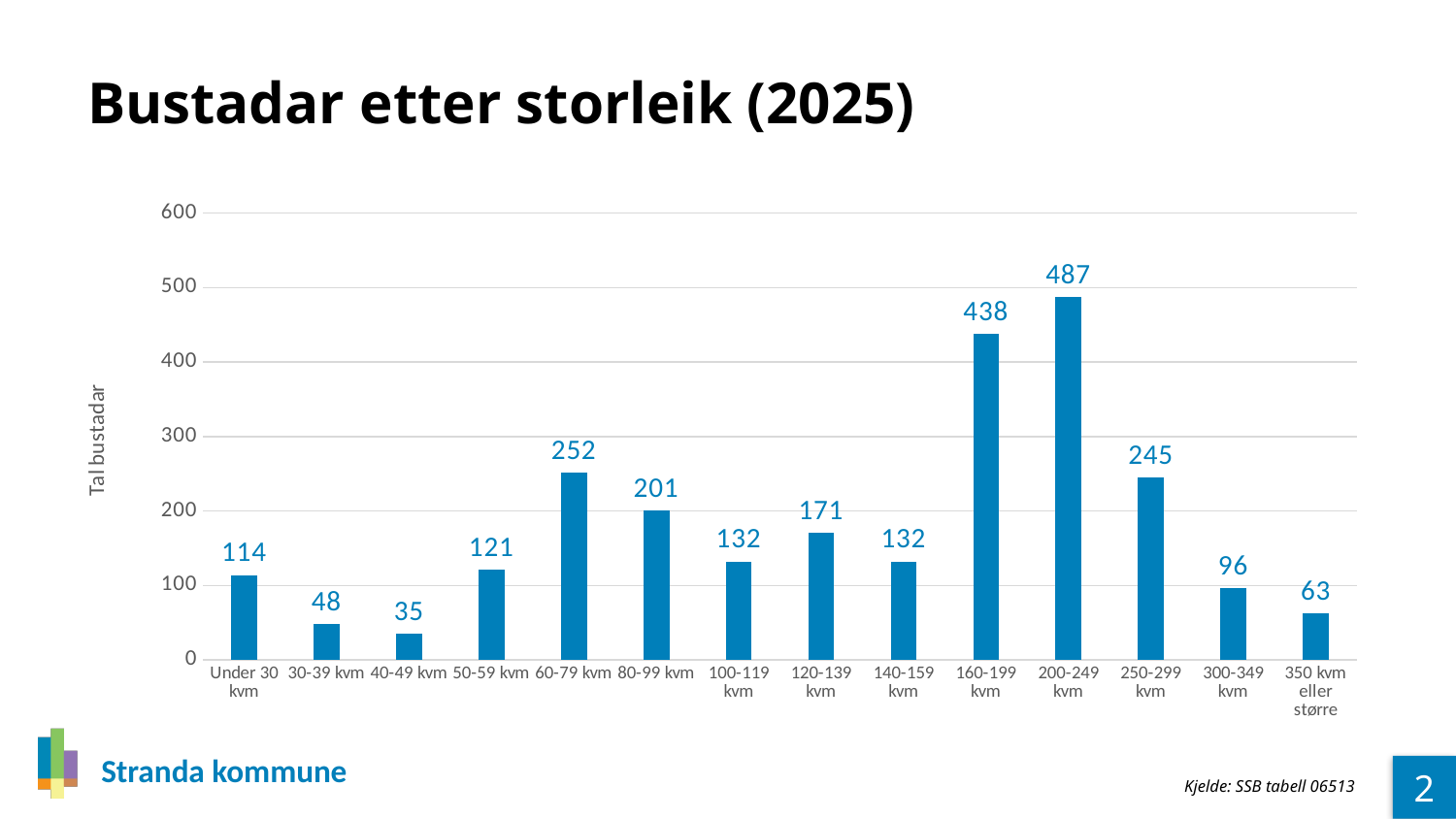
What is the title of the chart? Bustadar etter storleik (2025) Is the value for 160-199 kvm greater or less than 400? greater What is the difference between the values for 200-249 kvm and 160-199 kvm? 49 Which is larger, the value for 80-99 kvm or the value for 250-299 kvm? 250-299 kvm What is the label of the y axis? Tal bustadar What is the value for 60-79 kvm? 252 What kind of chart is shown on the slide? bar chart What is the value for 300-349 kvm? 96 Which category has the lowest value? 40-49 kvm Which category has the highest value? 200-249 kvm How many categories are shown on the x axis? 14 What is the value for 350 kvm eller større? 63